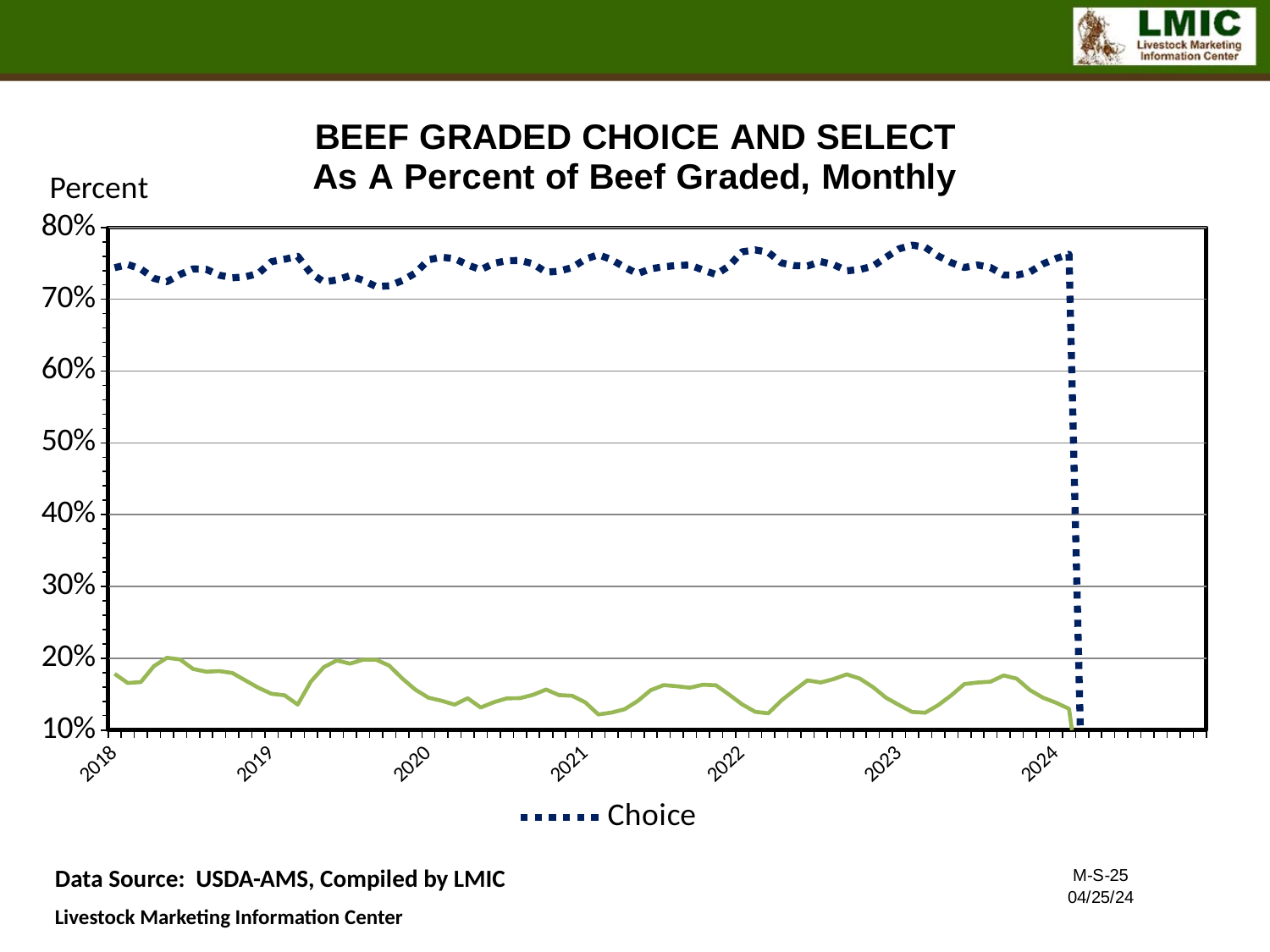
What is the title of the chart? BEEF GRADED CHOICE AND SELECT As A Percent of Beef Graded, Monthly Is the value of the solid green line at the start of 2021 greater or less than 20%? less Is the Choice value at the start of 2023 greater or less than 60%? greater Which is larger at the start of 2020: the Choice line or the solid green line? Choice How many series does the chart's legend list? 1 What is the first year labeled on the x-axis? 2018 Is the Choice value at the start of 2018 greater or less than 70%? greater How many year labels are shown on the x-axis? 7 What series name appears in the chart's legend? Choice What kind of chart is shown on the slide? line chart What is the highest value shown on the y-axis? 80%